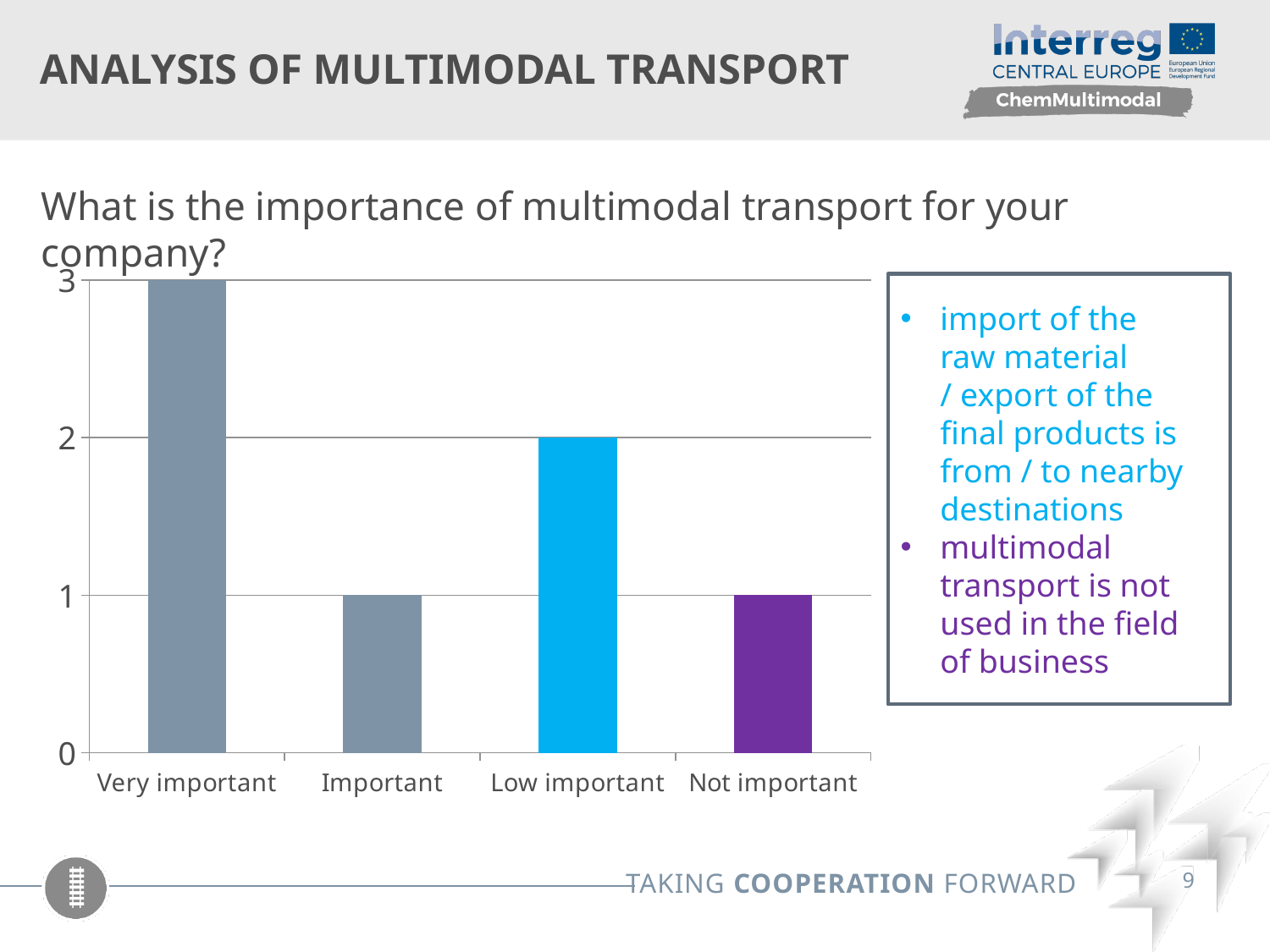
How many categories are shown on the x axis of the chart? 4 Which category has the highest value? Very important What is the value for "Very important"? 3 What is the value for "Not important"? 1 What is the value for "Important"? 1 What is the difference between the values for "Very important" and "Low important"? 1 What is the value for "Low important"? 2 What is the difference between the values for "Low important" and "Not important"? 1 What is the highest value shown on the y axis of the chart? 3 Which is larger, the value for "Very important" or the value for "Important"? Very important Is the value for "Low important" greater or less than 1? greater What kind of chart is shown on the slide? bar chart